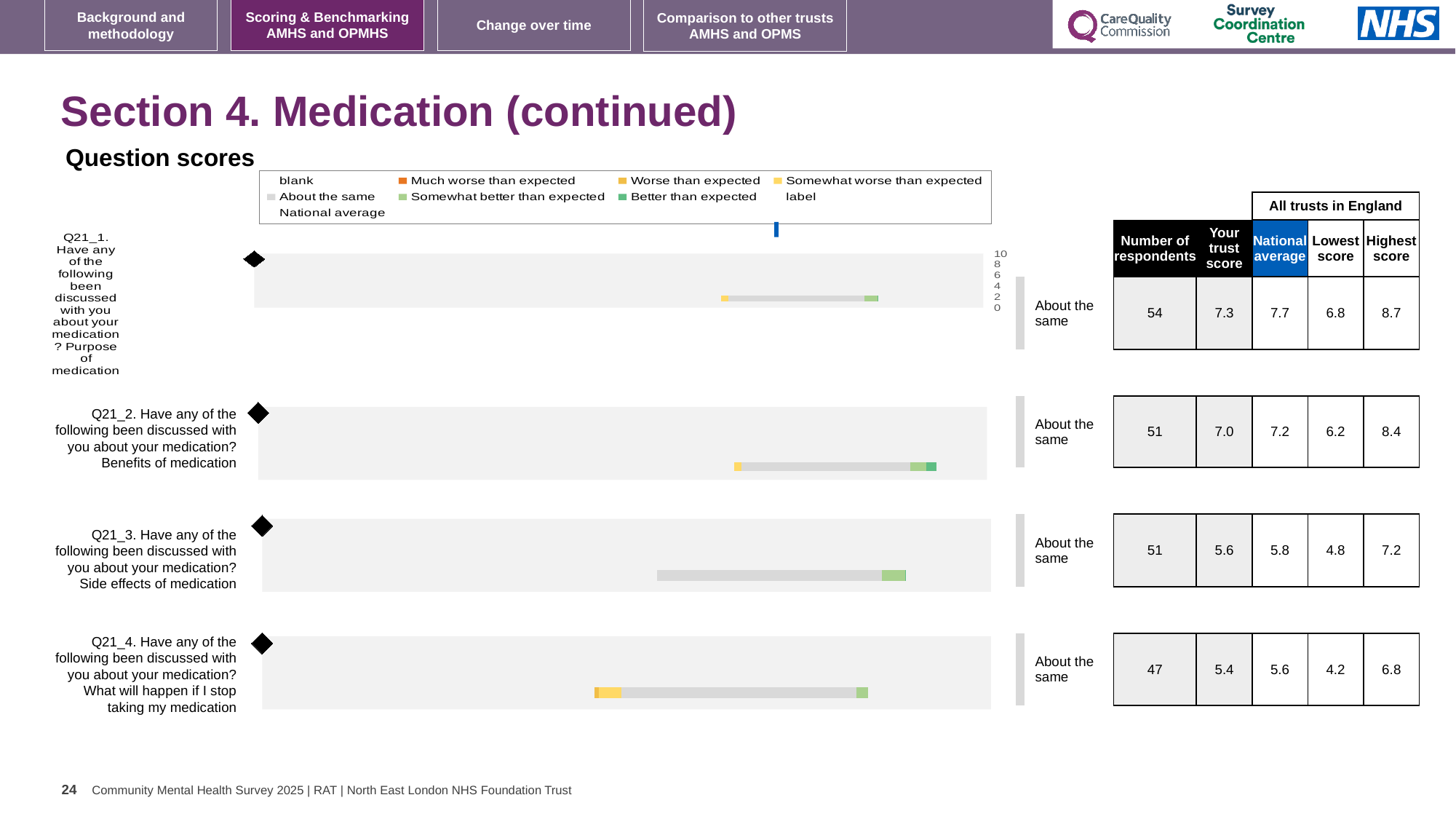
How many entries does the legend above the charts list? 9 For Q21_1 (Purpose of medication), what is the number of respondents shown in the table? 54 What type of chart is used to show the question scores on this slide? bar chart How many question charts (Q21_1 to Q21_4) are shown on the slide? 4 For Q21_2 (Benefits of medication), what is the difference between the highest score and the lowest score? 2.2 What benchmark category label is shown next to the Q21_3 (Side effects of medication) chart? About the same For Q21_2 (Benefits of medication), what is your trust score? 7.0 For Q21_3 (Side effects of medication), what is the national average? 5.8 For Q21_4 (What will happen if I stop taking my medication), what is the difference between the national average and your trust score? 0.2 For Q21_1 (Purpose of medication), which is larger: your trust score or the national average? national average For Q21_4 (What will happen if I stop taking my medication), what is the highest score among all trusts in England? 6.8 Which question has the lowest 'Your trust score' in the table? Q21_4. What will happen if I stop taking my medication